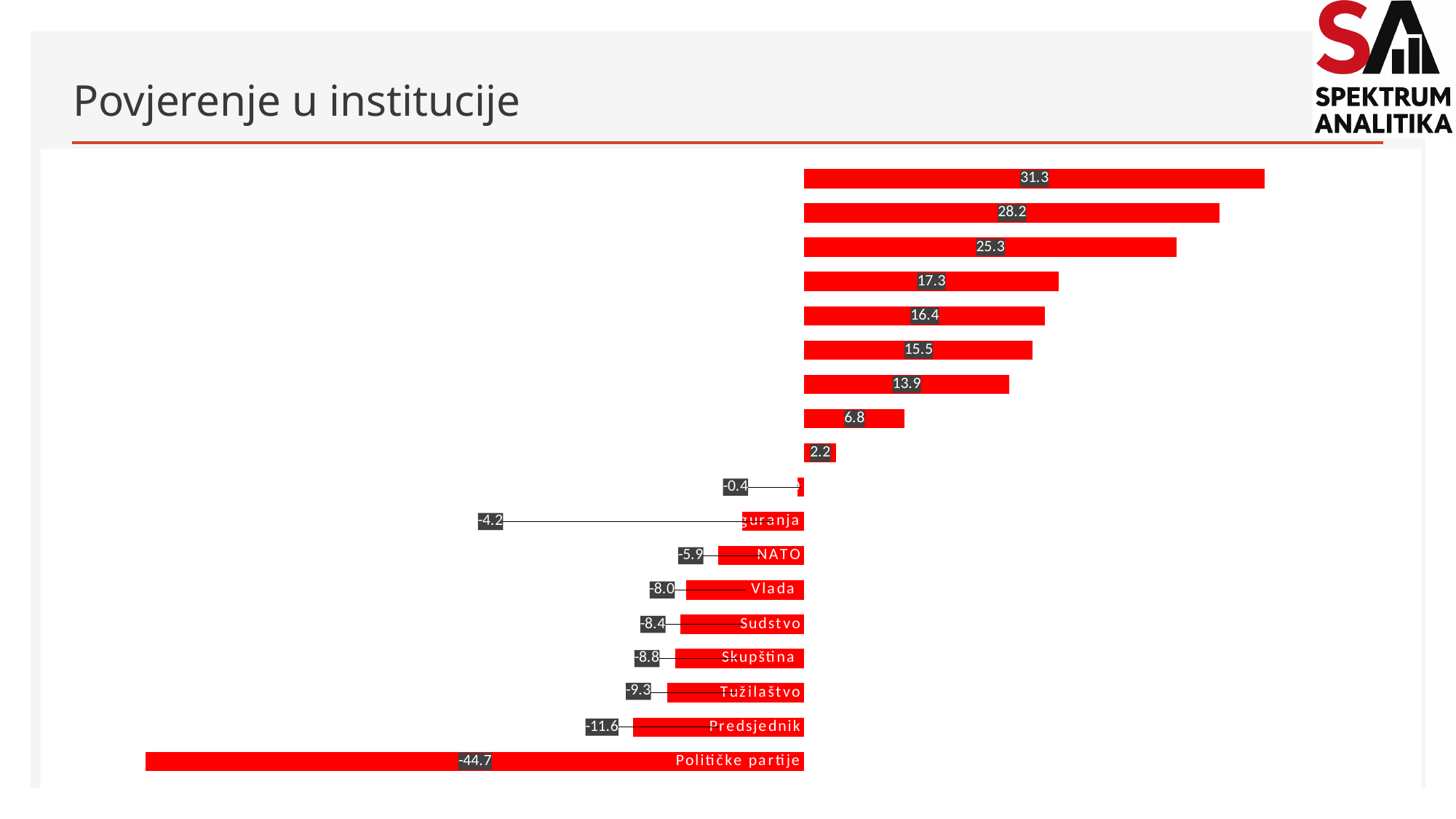
What kind of chart is shown on the slide? Bar chart What is the value for Vlada? -8.0 What is the value for Političke partije? -44.7 What is the value for Predsjednik? -11.6 Which category has the lowest value? Političke partije What is the value for Skupština? -8.8 What is the difference between the values for Predsjednik and Političke partije? 33.1 What is the value for NATO? -5.9 Which has the larger value, Vlada or Sudstvo? Vlada How many bars are shown on the chart? 18 What is the value for Tužilaštvo? -9.3 What is the highest value shown on the chart? 31.3